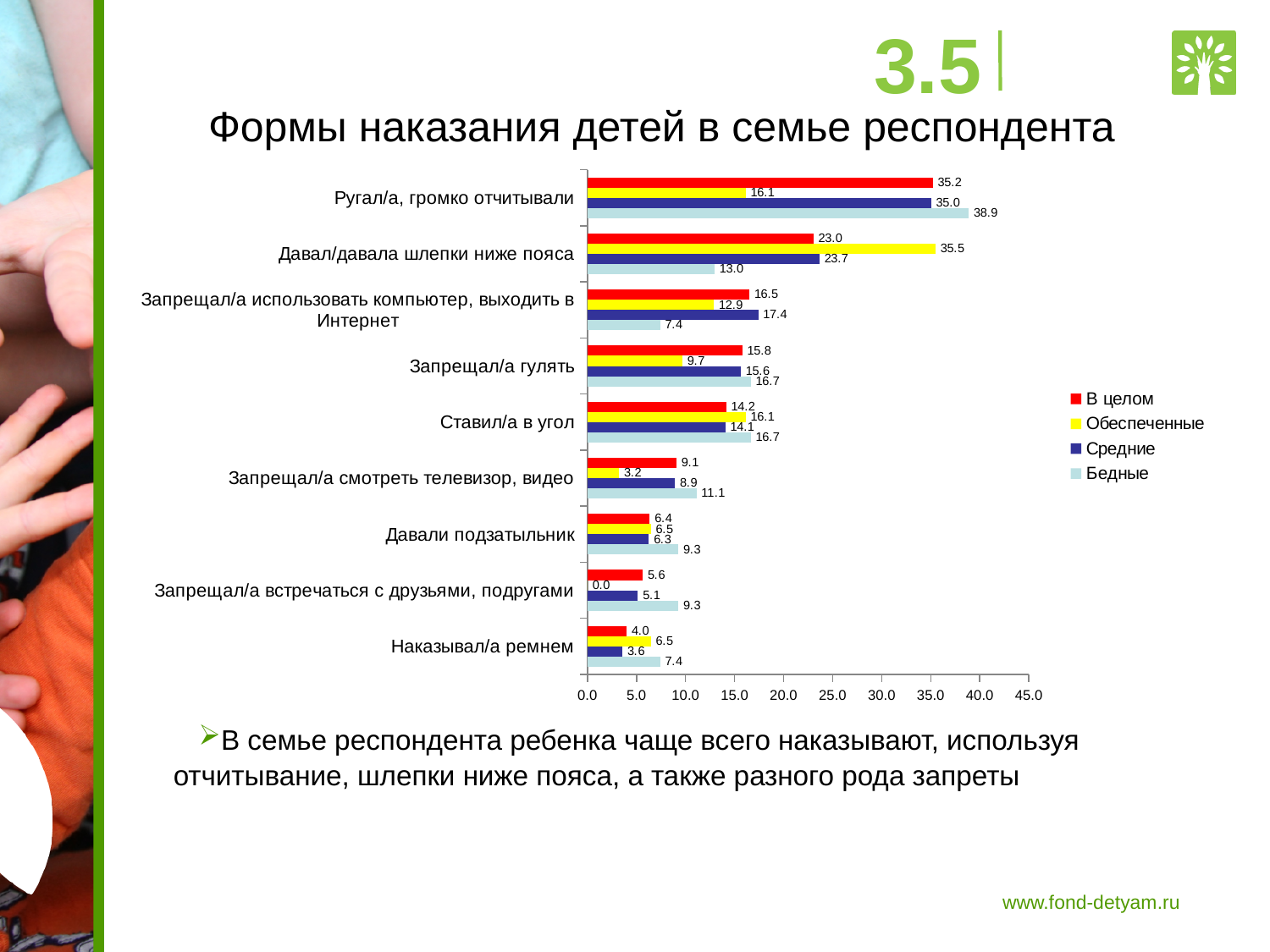
How many categories (forms of punishment) are shown on the chart? 9 Which category has the lowest value for the 'Обеспеченные' series? Запрещал/а встречаться с друзьями, подругами What is the difference between the 'Обеспеченные' and 'Бедные' values in the category 'Давал/давала шлепки ниже пояса'? 22.5 Is the value for 'Средние' in the category 'Ругал/а, громко отчитывали' greater or less than 30.0? greater What is the value for 'Бедные' in the category 'Ругал/а, громко отчитывали'? 38.9 What is the value for 'В целом' in the category 'Наказывал/а ремнем'? 4.0 What is the title of the chart? Формы наказания детей в семье респондента In the category 'Запрещал/а смотреть телевизор, видео', which is larger: the value for 'Бедные' or for 'Обеспеченные'? Бедные What type of chart is shown on the slide? Bar chart What is the value for 'Обеспеченные' in the category 'Давал/давала шлепки ниже пояса'? 35.5 How many series does the legend list? 4 Which category has the highest value for the 'В целом' series? Ругал/а, громко отчитывали